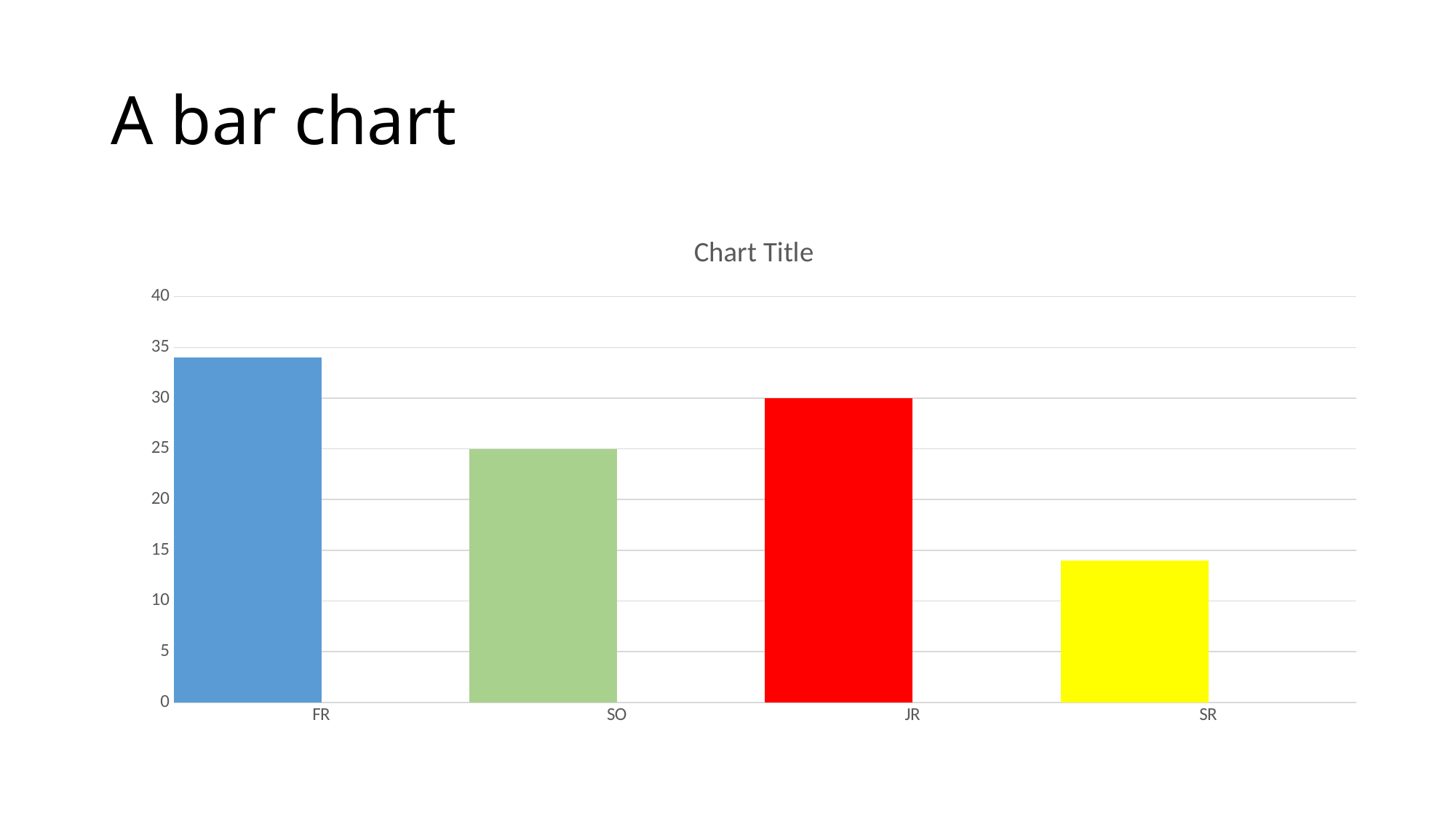
Is the value for SR greater or less than 15? less What is the value for SO in the chart? 25 Which is larger, the value for JR or the value for SO? JR Which category has the highest bar in the chart? FR What kind of chart is shown on the slide? bar chart What is the title shown above the chart? Chart Title Is the value for FR greater or less than 35? less Which category has the lowest bar in the chart? SR Is the value for FR greater or less than 30? greater What is the value for JR in the chart? 30 What is the difference between the values for JR and SO? 5 How many categories are shown on the x axis of the chart? 4